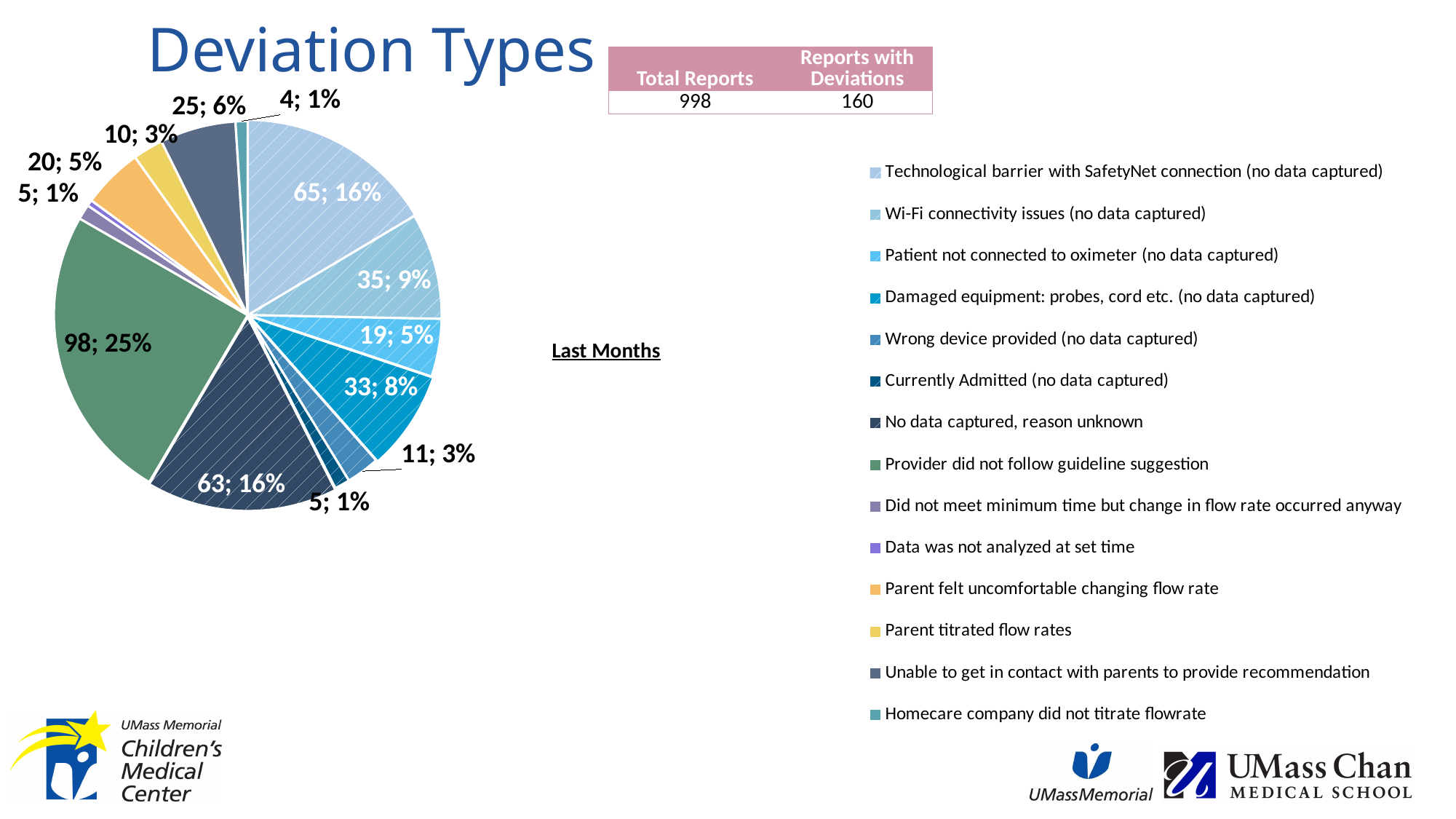
Which deviation type has the largest slice of the pie? Provider did not follow guideline suggestion Which has a larger count: 'Technological barrier with SafetyNet connection (no data captured)' or 'No data captured, reason unknown'? Technological barrier with SafetyNet connection (no data captured) What is the data label for the 'Technological barrier with SafetyNet connection (no data captured)' slice? 65; 16% What is the title of the slide's chart? Deviation Types What is the data label for the 'Wi-Fi connectivity issues (no data captured)' slice? 35; 9% What is the data label for the 'Damaged equipment: probes, cord etc. (no data captured)' slice? 33; 8% What is the data label for the 'Parent felt uncomfortable changing flow rate' slice? 20; 5% What is the difference in count between 'Provider did not follow guideline suggestion' (98) and 'No data captured, reason unknown' (63)? 35 How many deviation types are listed in the chart's legend? 14 What kind of chart is shown on the slide? pie chart What is the data label for the 'Unable to get in contact with parents to provide recommendation' slice? 25; 6% What share of the pie does 'Provider did not follow guideline suggestion' represent? 25%